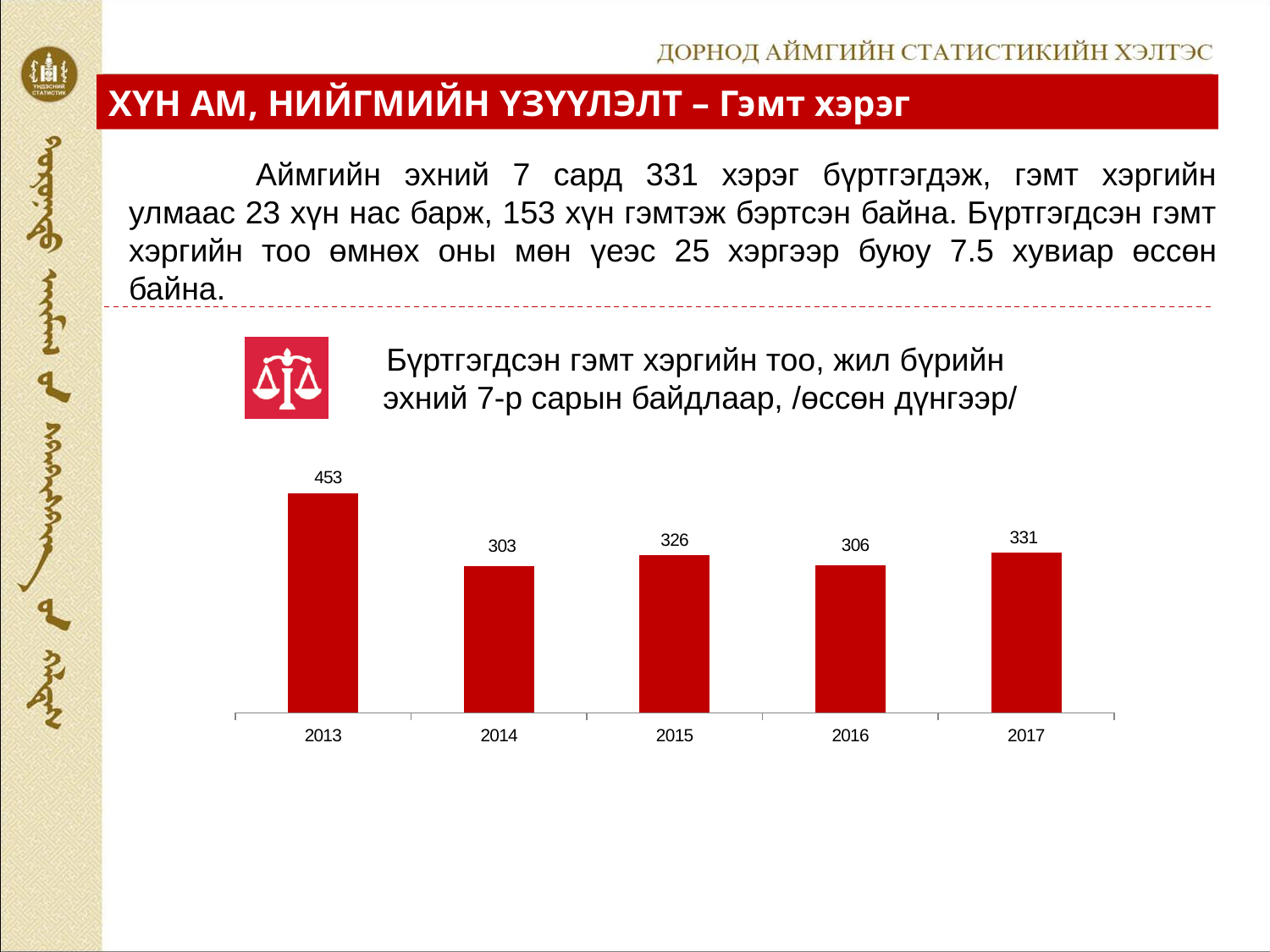
What is the value shown for 2015? 326 What colour are the bars in the chart? red What is the number of registered crimes for 2017? 331 What kind of chart is shown on the slide? bar chart Which is larger, the value for 2015 or the value for 2016? 2015 Which year has the lowest number of registered crimes? 2014 Which year has the highest number of registered crimes? 2013 Does the number of registered crimes rise or fall from 2013 to 2014? fall What is the difference between the values for 2017 and 2016? 25 What is the difference between the values for 2013 and 2014? 150 What is the number of registered crimes for 2013? 453 How many years are shown on the chart? 5